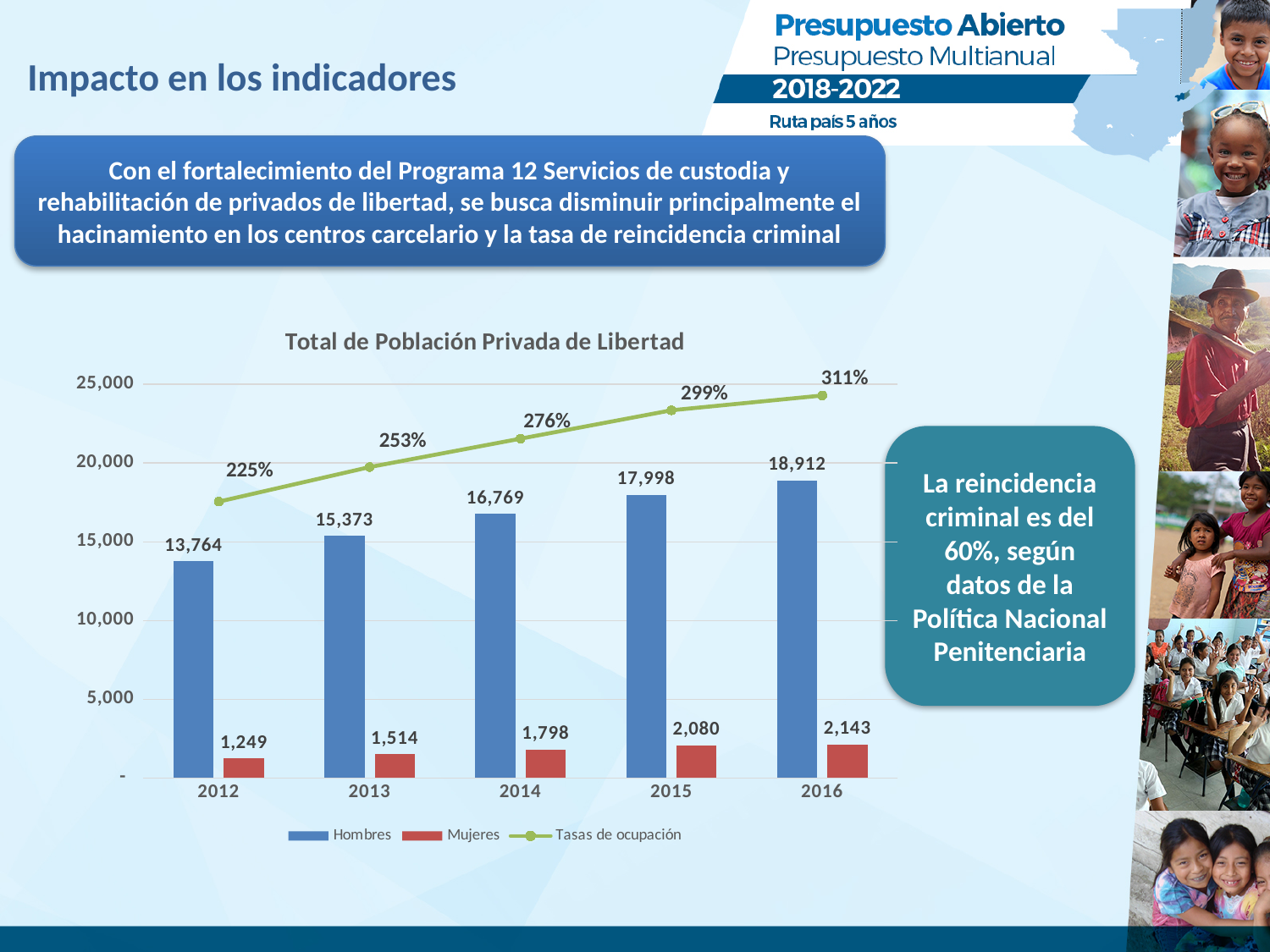
Which is larger, the Hombres value for 2014 or for 2015? 2015 What is the title of the chart? Total de Población Privada de Libertad How many series does the legend list? 3 Does the Tasas de ocupación line rise or fall from 2012 to 2016? rise What is the difference between the Mujeres values for 2015 and 2014? 282 What is the Tasas de ocupación value for 2013? 253% Which year has the highest value for Hombres? 2016 How many years are shown on the x axis? 5 What is the value for Hombres in 2016? 18,912 What is the difference between the Hombres values for 2016 and 2012? 5,148 Which year has the lowest value for Mujeres? 2012 What is the value for Mujeres in 2014? 1,798